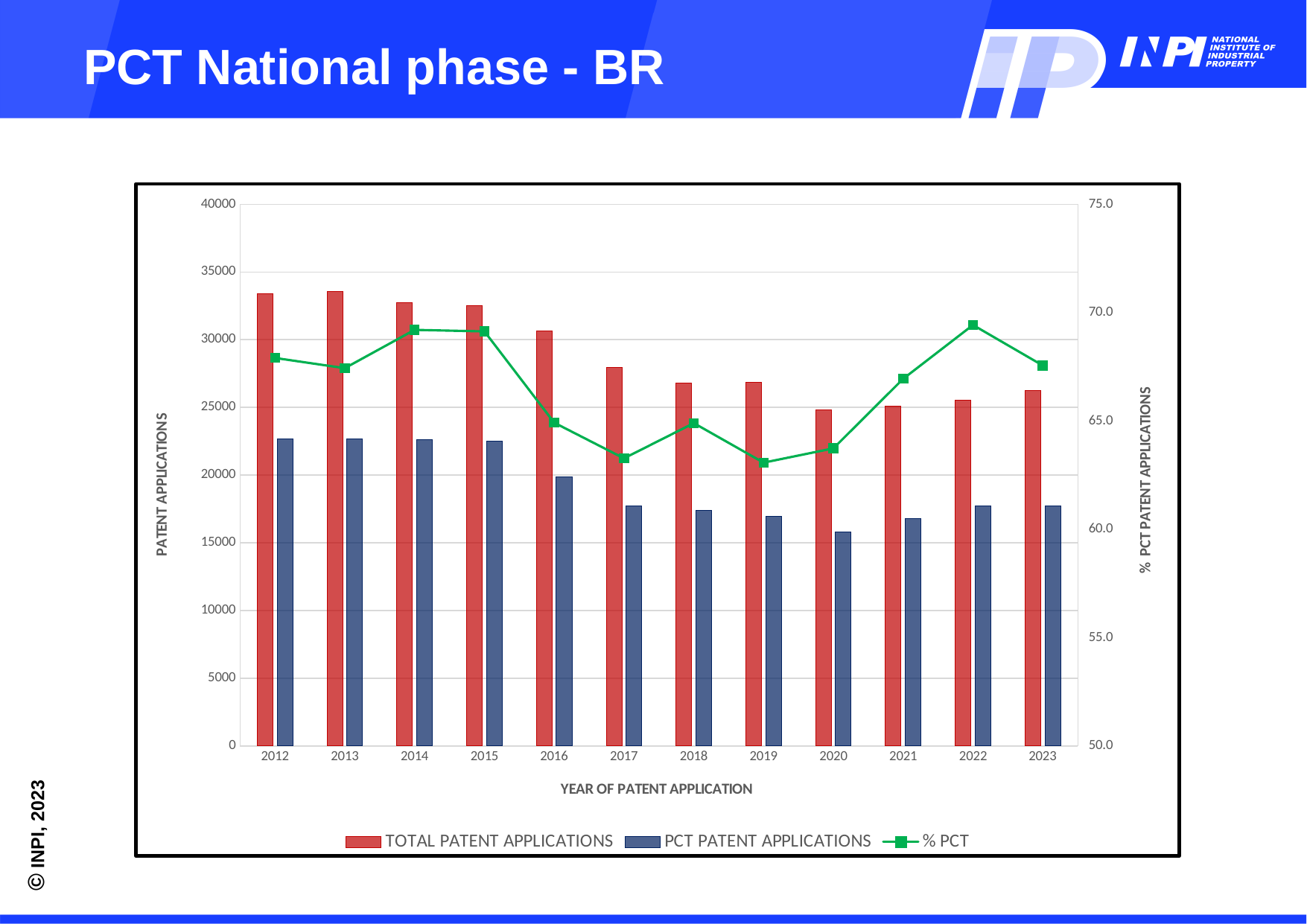
Is the % PCT value in 2019 greater or less than 65.0? less Is the % PCT value in 2022 greater or less than 65.0? greater Do the TOTAL PATENT APPLICATIONS values rise or fall from 2012 to 2020? fall Is the value for PCT PATENT APPLICATIONS in 2020 greater or less than 20000? less Which is larger, the % PCT value in 2015 or in 2017? 2015 Which is larger, TOTAL PATENT APPLICATIONS in 2012 or in 2020? 2012 How many years are shown on the x axis of the chart? 12 What kind of chart is shown on the slide? A bar chart combined with a line How many series does the chart's legend list? 3 Which year has the lowest value for PCT PATENT APPLICATIONS? 2020